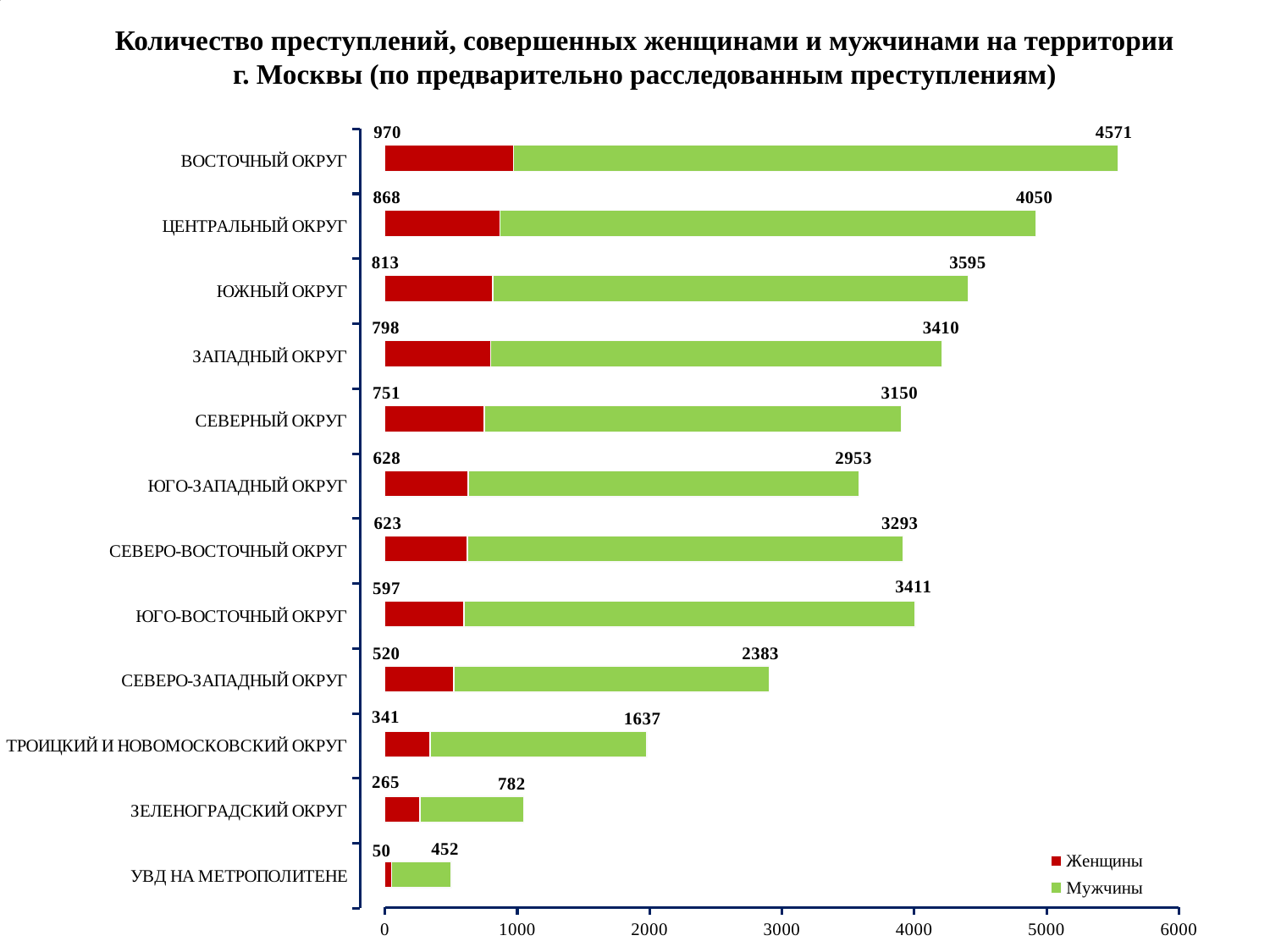
How many series does the legend list? 2 What is the difference between the Мужчины values for ЦЕНТРАЛЬНЫЙ ОКРУГ and ЮЖНЫЙ ОКРУГ? 455 What is the value for Мужчины in ЗЕЛЕНОГРАДСКИЙ ОКРУГ? 782 What is the total of the stacked bar for ЗЕЛЕНОГРАДСКИЙ ОКРУГ? 1047 Which category has the lowest value for Женщины? УВД НА МЕТРОПОЛИТЕНЕ Which district has the highest value for Мужчины? ВОСТОЧНЫЙ ОКРУГ How many categories (districts) are shown on the chart? 12 How many crimes committed by women (Женщины) are shown for ВОСТОЧНЫЙ ОКРУГ? 970 Which has a larger Мужчины value: СЕВЕРО-ВОСТОЧНЫЙ ОКРУГ or СЕВЕРНЫЙ ОКРУГ? СЕВЕРО-ВОСТОЧНЫЙ ОКРУГ Is the total length of the stacked bar for ВОСТОЧНЫЙ ОКРУГ greater or less than 5000? greater What kind of chart is shown on the slide? Stacked bar chart Which colour represents Женщины in the legend? Red